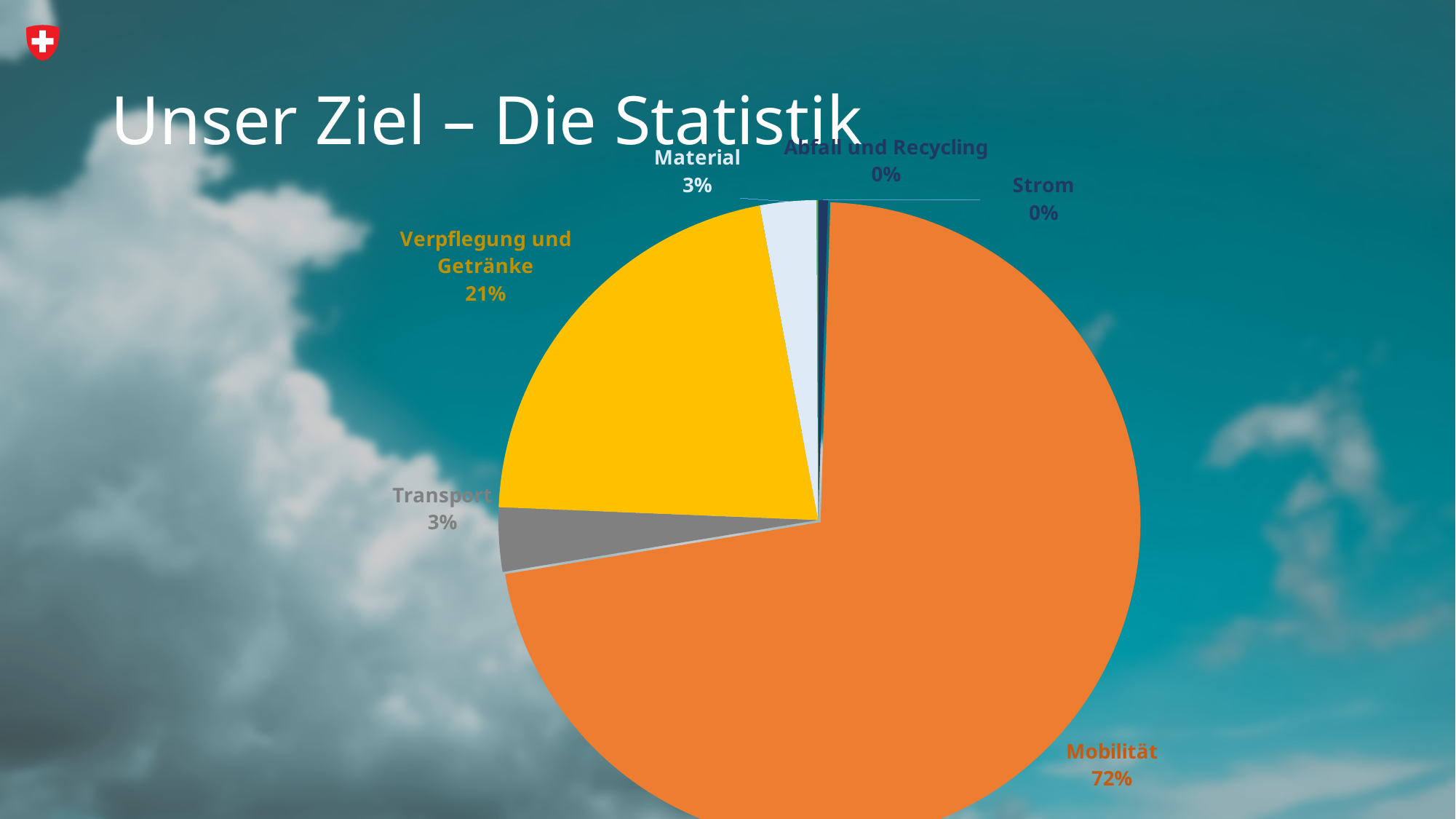
Which is larger, Verpflegung und Getränke or Material? Verpflegung und Getränke What is the value shown for Material? 3% How many categories are labelled on the pie chart? 6 What kind of chart is shown on the slide? pie chart What is the title of the slide containing the chart? Unser Ziel – Die Statistik What is the difference in percentage points between Mobilität and Verpflegung und Getränke? 51 What is the value shown for Transport? 3% What is the value shown for Abfall und Recycling? 0% What is the value shown for Strom? 0% What share of the pie does Verpflegung und Getränke have? 21% Which category has the largest slice of the pie? Mobilität What share of the pie does Mobilität have? 72%